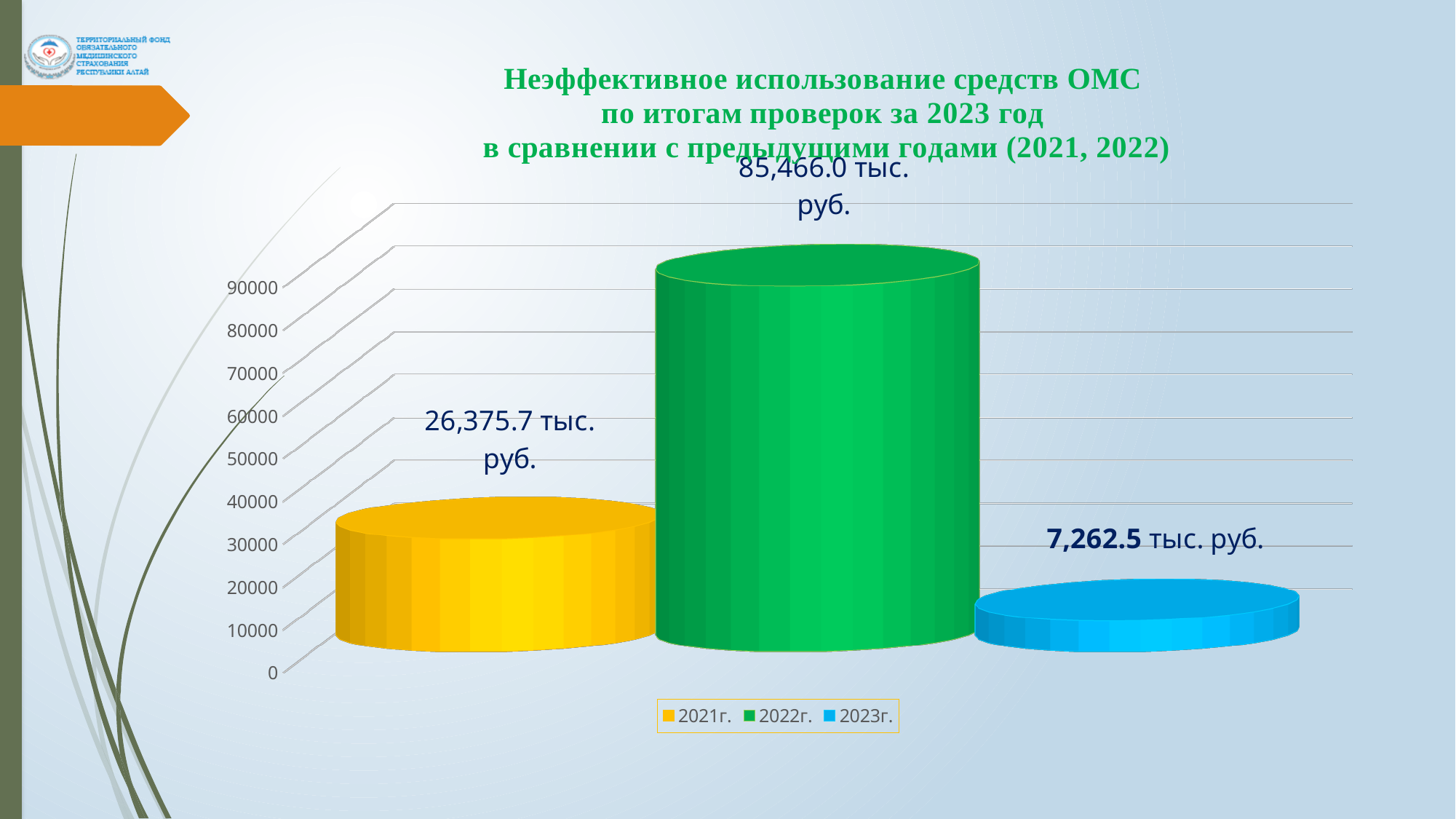
What is the difference between the values for 2021г. and 2023г.? 19,113.2 тыс. руб. Which is larger, the value for 2021г. or the value for 2023г.? 2021г. What is the value shown for 2023г.? 7,262.5 тыс. руб. What is the difference between the values for 2022г. and 2021г.? 59,090.3 тыс. руб. What is the value shown for 2022г.? 85,466.0 тыс. руб. What kind of chart is shown on the slide? bar chart Which year has the highest value? 2022г. Is the value for 2022г. greater or less than 80000? greater What colour is the bar for 2023г.? blue Which year has the lowest value? 2023г. What is the value shown for 2021г.? 26,375.7 тыс. руб. How many series does the legend list? 3